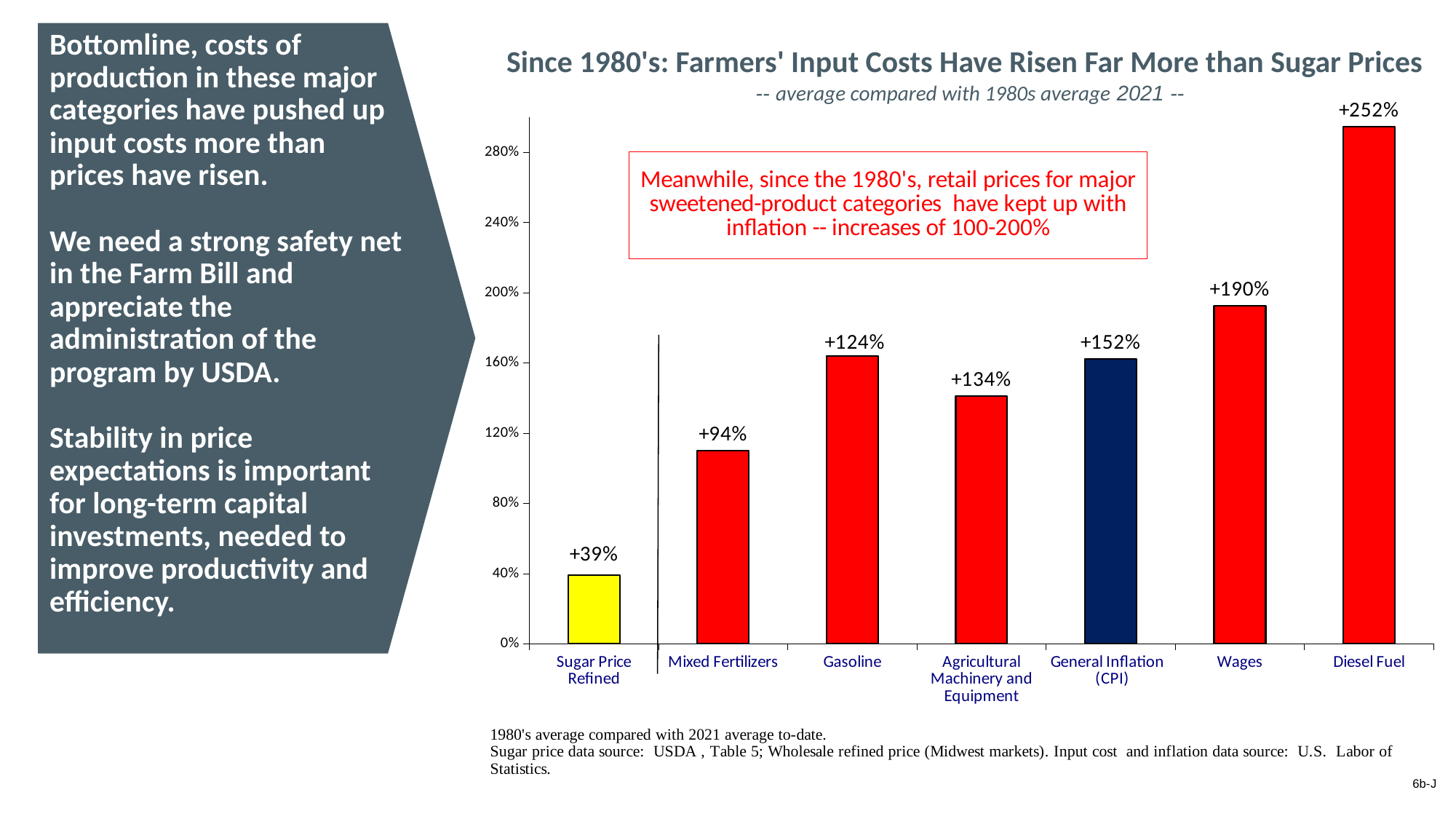
What is the difference between the values for Wages and Mixed Fertilizers? 96% What is the value shown for Sugar Price Refined? +39% What is the title of the chart? Since 1980's: Farmers' Input Costs Have Risen Far More than Sugar Prices What is the value shown for Agricultural Machinery and Equipment? +134% What is the value shown for Diesel Fuel? +252% Which category has the lowest value? Sugar Price Refined What is the value shown for General Inflation (CPI)? +152% What colour is the bar for Sugar Price Refined? Yellow How many categories are shown on the x axis? 7 Which category has the highest value? Diesel Fuel What kind of chart is shown on the slide? Bar chart